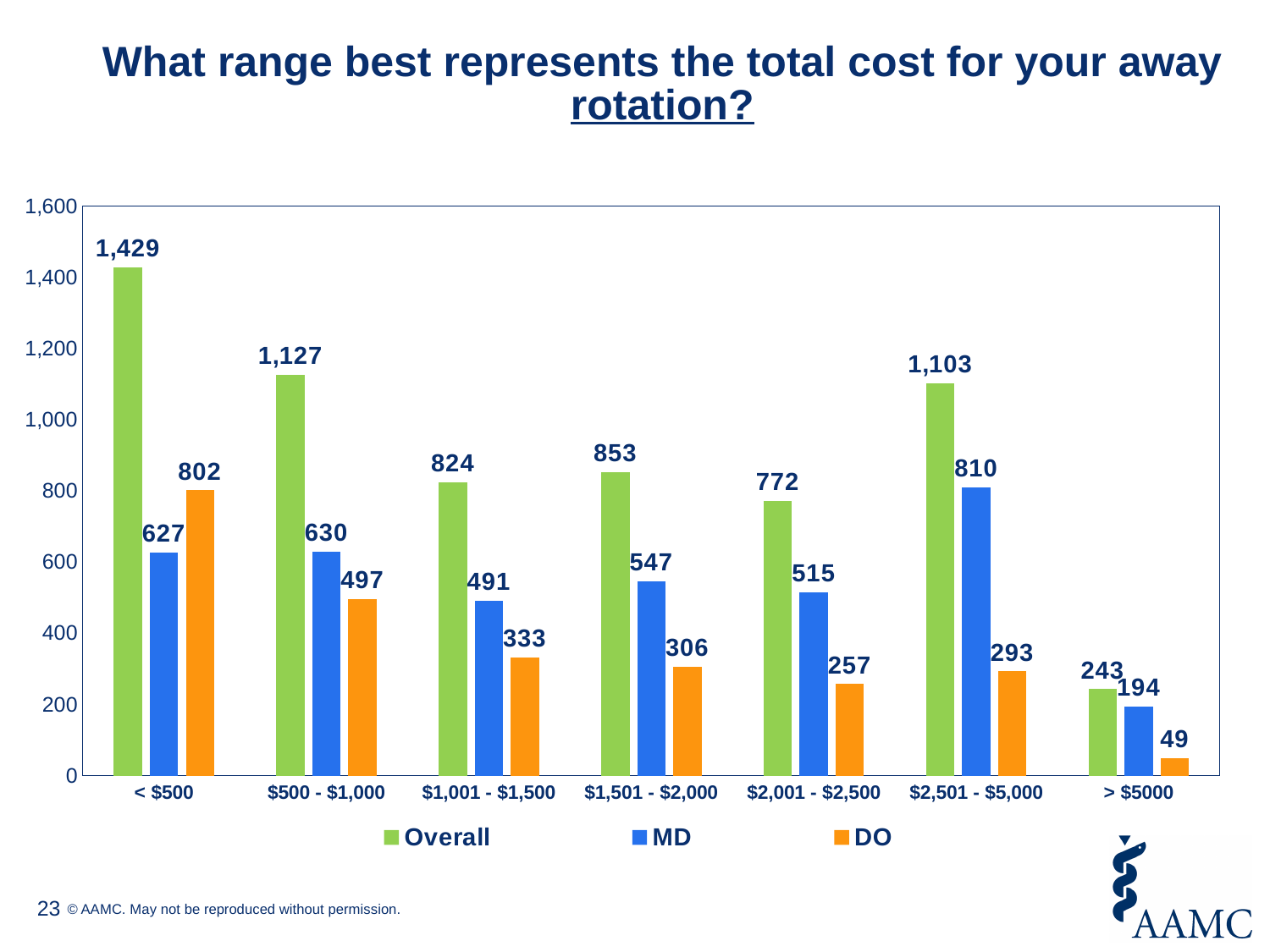
How many cost range categories are shown on the x axis? 7 What kind of chart is shown on the slide? Bar chart What is the MD value for the $2,501 - $5,000 category? 810 Which category has the highest Overall value? < $500 Which category has the lowest DO value? > $5000 What is the Overall value for the < $500 category? 1,429 What is the difference between the MD and DO values for the $1,501 - $2,000 category? 241 Does the DO value rise or fall from the $500 - $1,000 category to the $2,001 - $2,500 category? Fall Which series is shown in orange in the legend? DO How many series does the legend list? 3 Which is larger for the < $500 category: the MD value or the DO value? DO What is the DO value for the > $5000 category? 49